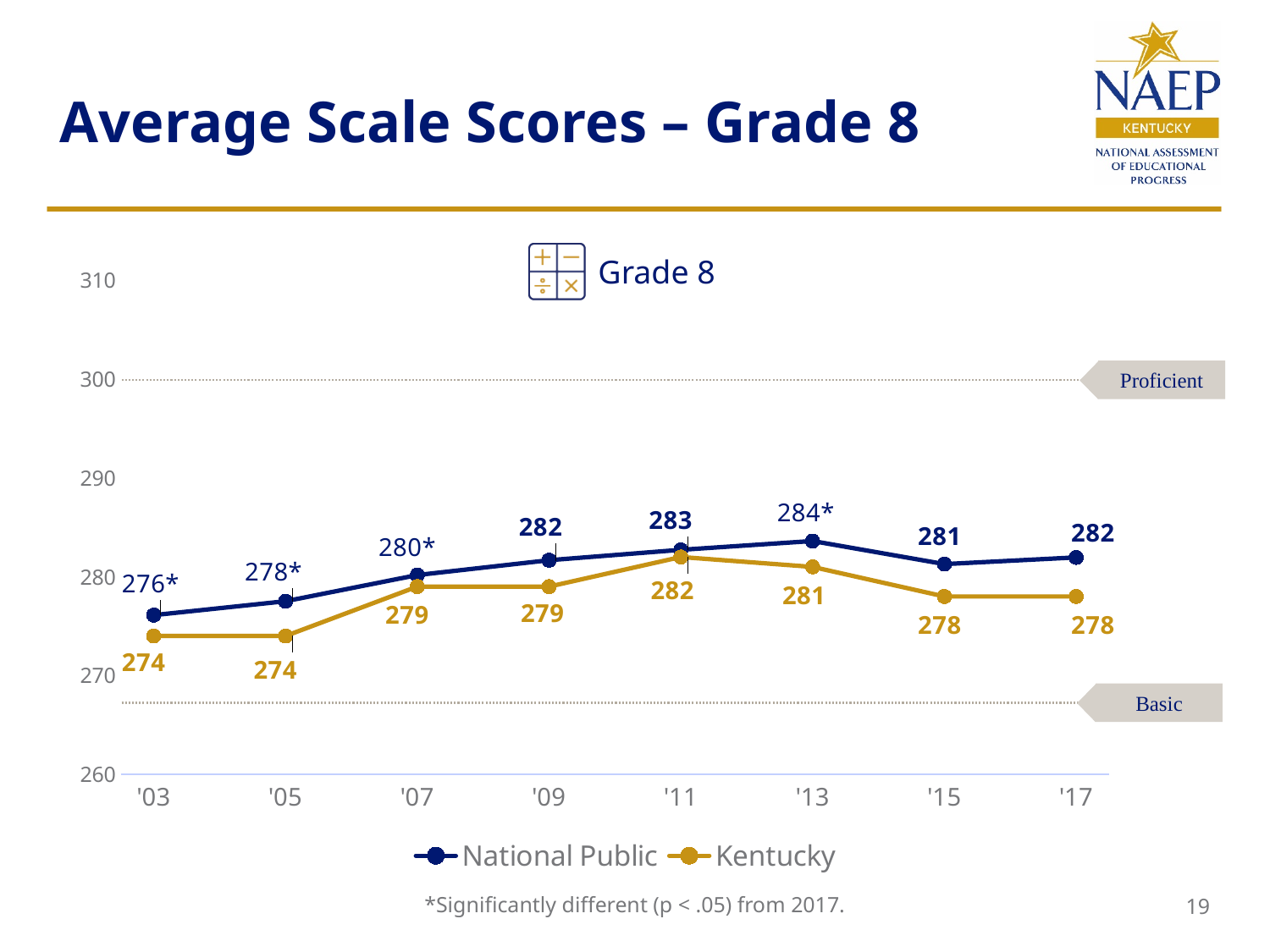
What is the National Public average scale score in '09? 282 What is the difference between the National Public and Kentucky scores in '17? 4 What is the chart's title shown above the plot area? Grade 8 Which is larger in '15, the National Public score or the Kentucky score? National Public How many series does the legend list? 2 What is the Kentucky average scale score in '17? 278 What kind of chart is shown on the slide? line chart How many years are plotted along the x axis? 8 Is the Kentucky score in '03 greater or less than 280? less What is the Kentucky average scale score in '11? 282 In which years is the Kentucky score lowest? '03 and '05 In which year is the National Public score highest? '13